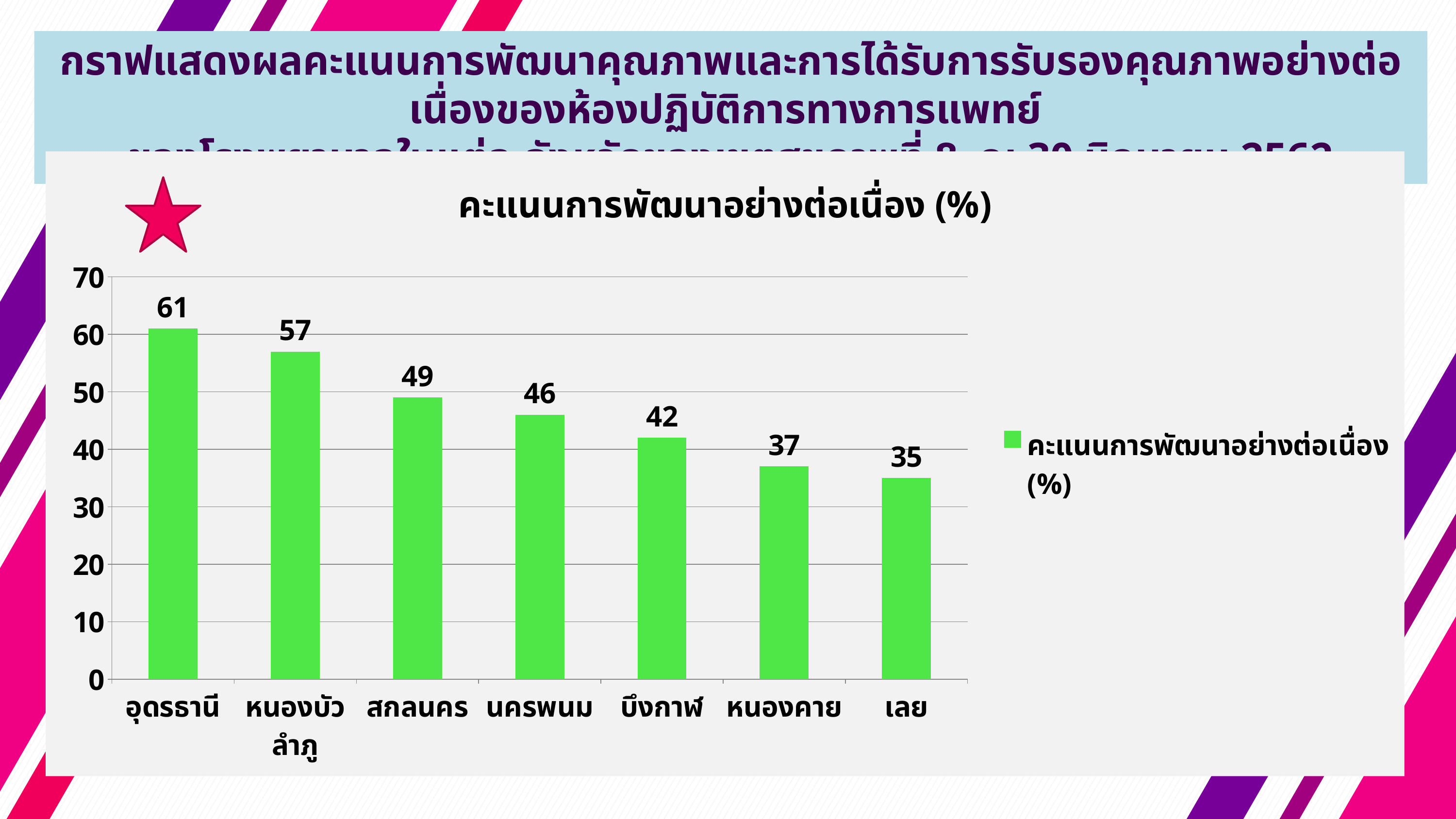
What is the difference between the values for สกลนคร and หนองคาย? 12 What is the difference between the values for อุดรธานี and หนองบัวลำภู? 4 Which category has the highest value? อุดรธานี What is the value for บึงกาฬ? 42 Which is larger, the value for นครพนม or the value for บึงกาฬ? นครพนม What kind of chart is shown? bar chart What is the value for อุดรธานี? 61 How many categories are shown on the x axis? 7 Do the values rise or fall from left to right along the x axis? fall Which category has the lowest value? เลย What is the value for เลย? 35 Is the value for หนองคาย greater or less than 40? less